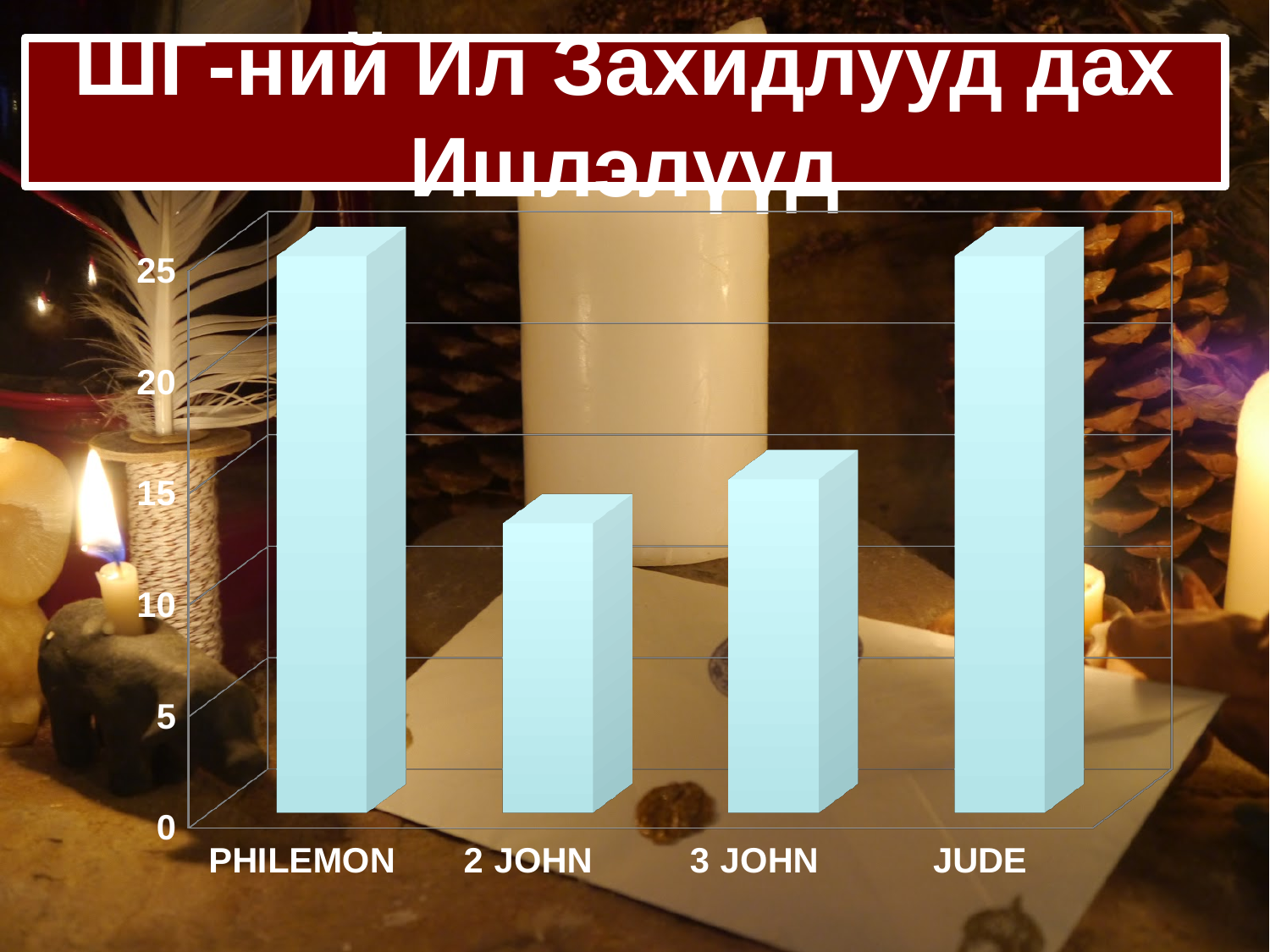
Is the value for PHILEMON greater or less than 20? greater Is the value for 2 JOHN greater or less than 15? less Is the value for 3 JOHN greater or less than 10? greater What kind of chart is shown on the slide? bar chart Which category has the lowest bar in the chart? 2 JOHN What is the label of the first category on the x axis? PHILEMON Which is larger, the value for 2 JOHN or the value for 3 JOHN? 3 JOHN Which is larger, the value for PHILEMON or the value for 2 JOHN? PHILEMON How many categories are shown on the x axis of the chart? 4